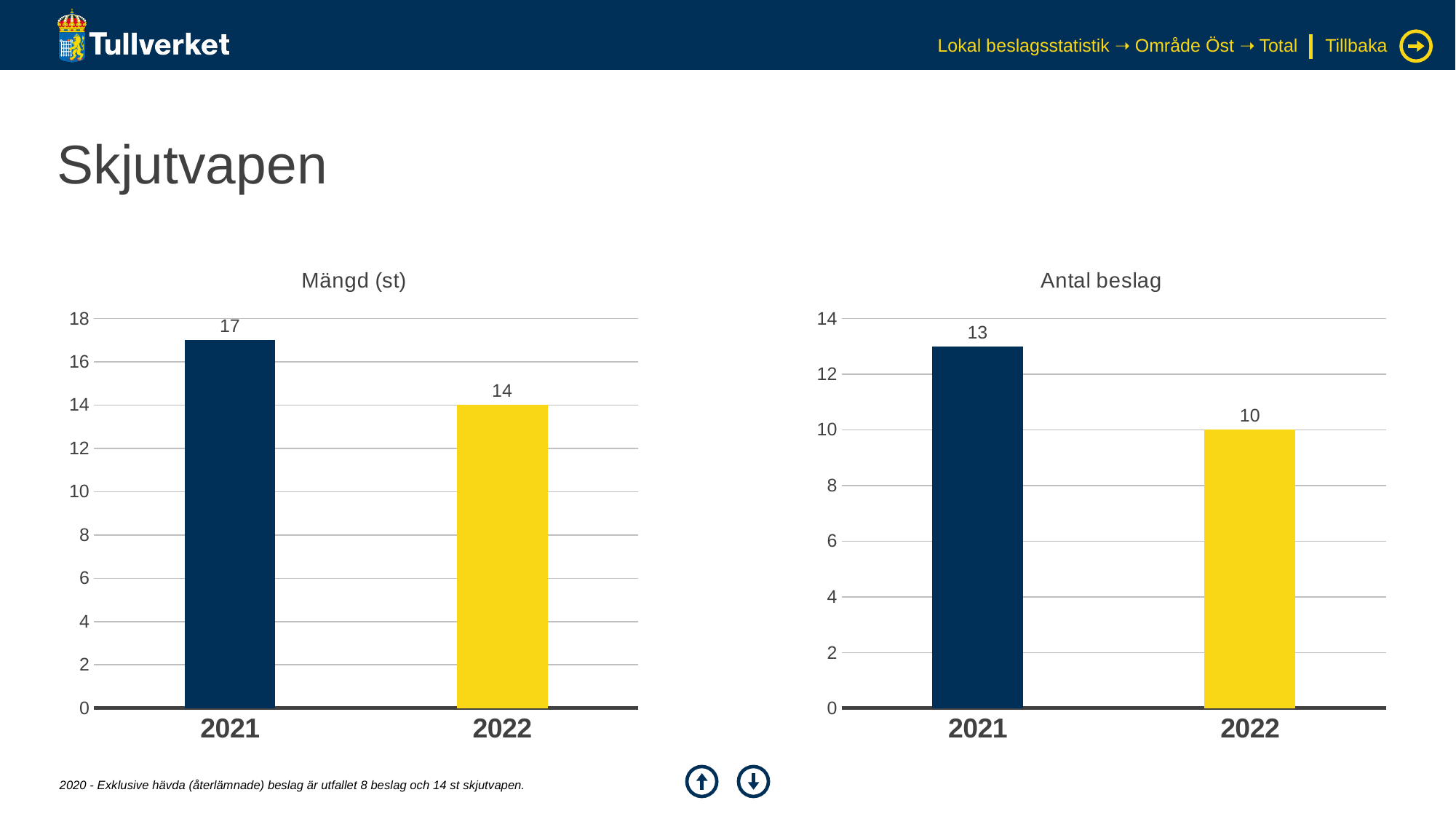
In the 'Mängd (st)' chart, what is the difference between the 2021 and 2022 values? 3 In the 'Mängd (st)' chart, which year has the highest value? 2021 How many categories are shown on the x axis of the 'Mängd (st)' chart? 2 In the 'Antal beslag' chart, which year has the lowest value? 2022 In the 'Antal beslag' chart, what is the value for 2022? 10 In the 'Antal beslag' chart, what is the value for 2021? 13 In the 'Mängd (st)' chart, do the values rise or fall from 2021 to 2022? fall In the 'Mängd (st)' chart, what is the value for 2022? 14 In the 'Antal beslag' chart, is the value for 2021 greater or less than 12? greater What kind of chart is the 'Antal beslag' chart? bar chart In the 'Mängd (st)' chart, what is the value for 2021? 17 In the 'Antal beslag' chart, what is the difference between the 2021 and 2022 values? 3